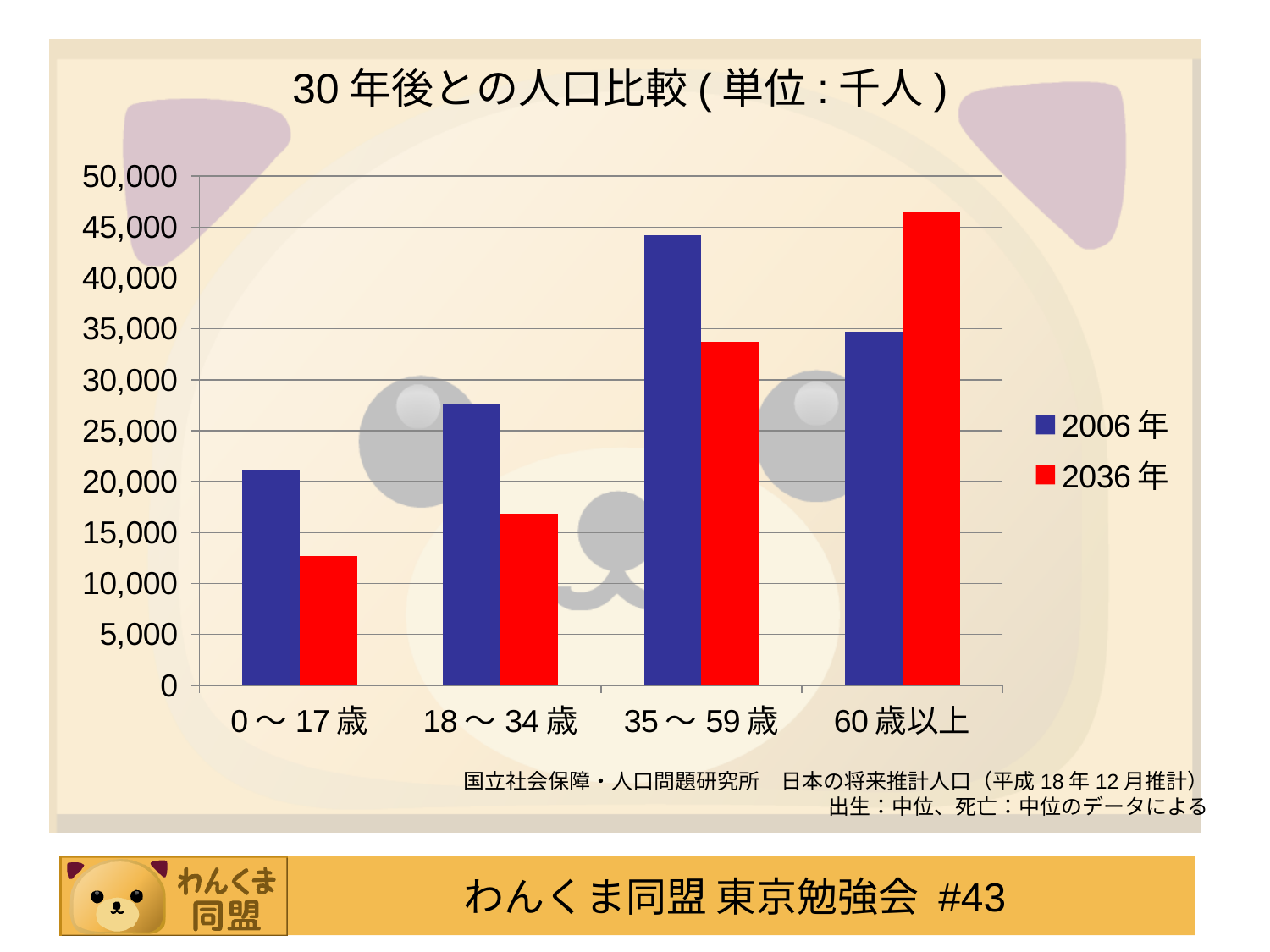
Which age category has the highest value for 2006年? 35～59歳 Do the 2036年 values rise or fall as you move from 0～17歳 to 60歳以上? rise For 35～59歳, which series has the larger value, 2006年 or 2036年? 2006年 Is the value for 0～17歳 in 2036年 greater or less than 15,000? less Which age category has the highest value for 2036年? 60歳以上 How many age categories are shown on the x axis? 4 How many series does the legend list? 2 Which age category has the lowest value for 2036年? 0～17歳 What is the title of the chart? 30年後との人口比較(単位:千人) For 60歳以上, which series has the larger value, 2006年 or 2036年? 2036年 What kind of chart is shown on the slide? bar chart Is the value for 60歳以上 in 2036年 greater or less than 45,000? greater